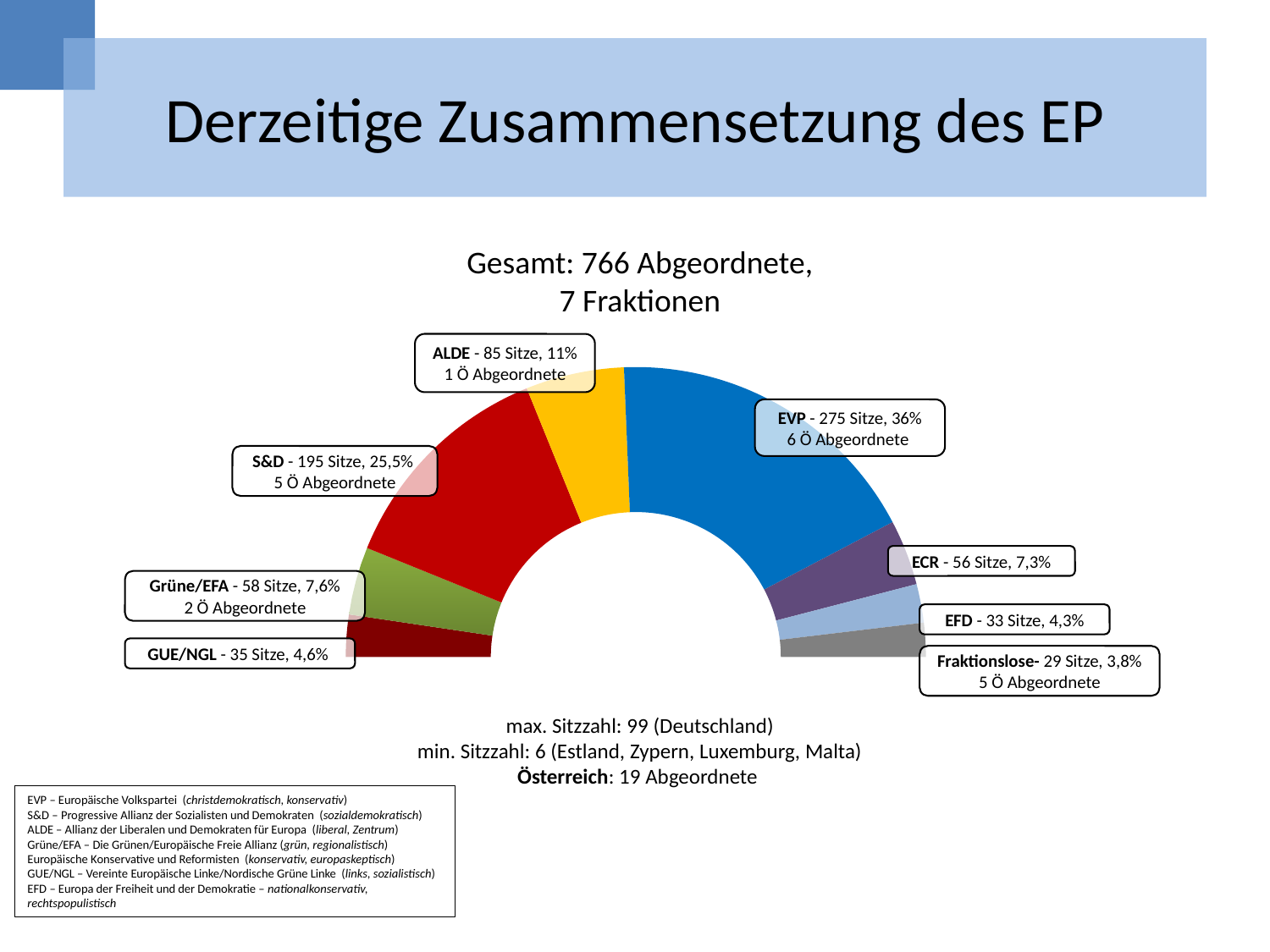
How many segments does the chart show? 8 What percentage share is shown for S&D? 25,5% What percentage share is shown for EFD? 4,3% What is the difference in seats between EVP and S&D? 80 What kind of chart is shown on the slide? Pie chart (half-donut) Which segment has the smallest number of seats in the chart? Fraktionslose What is the total number of Abgeordnete stated above the chart? 766 How many seats are shown for ALDE? 85 Sitze How many Ö Abgeordnete are listed for EVP? 6 Which has more seats, Grüne/EFA or ECR? Grüne/EFA Which group has the largest number of seats in the chart? EVP How many seats does the EVP group have according to the chart? 275 Sitze